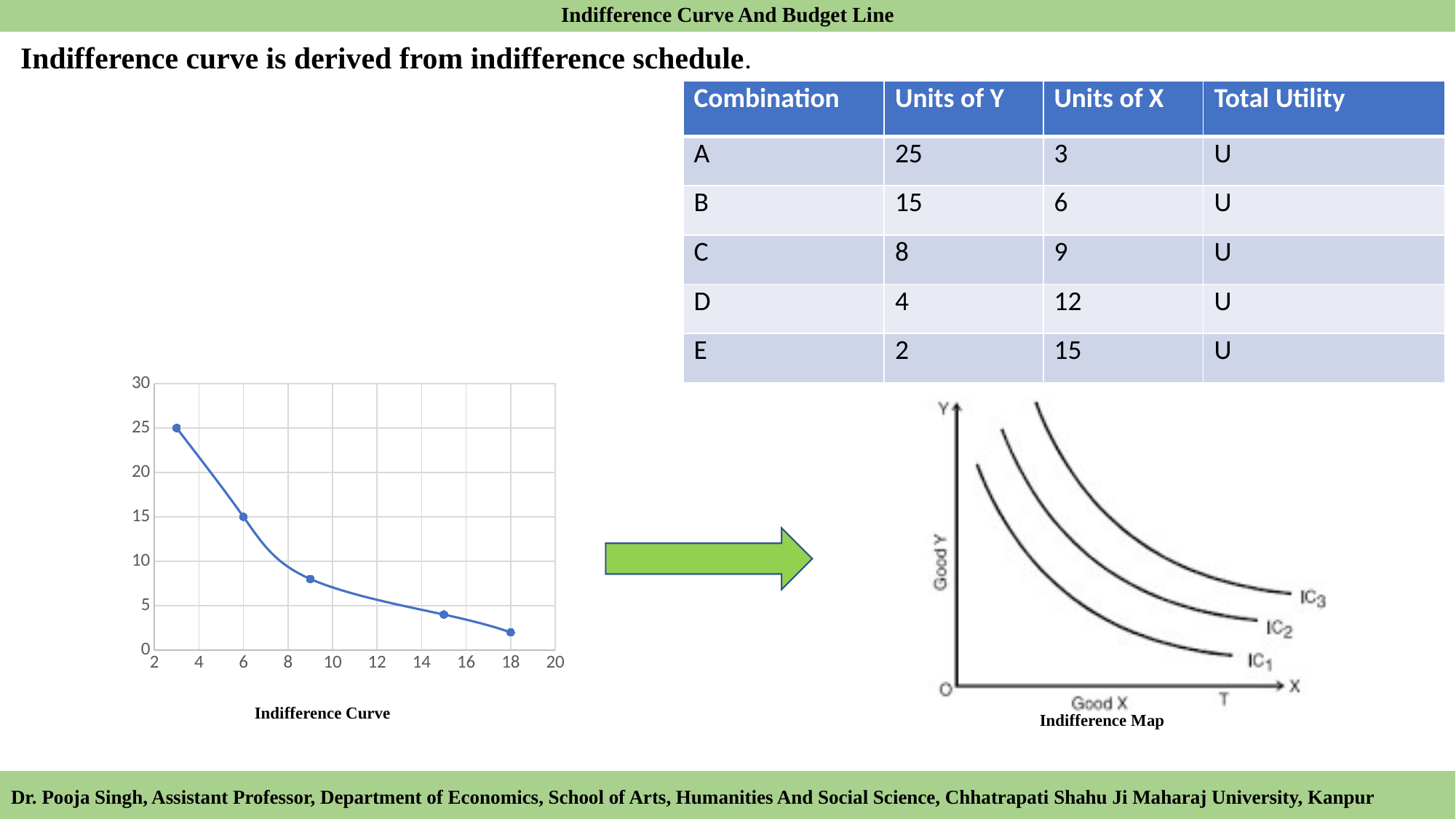
How many data points are plotted on the "Indifference Curve" chart? 5 What kind of chart is the "Indifference Curve" chart on the left of the slide? line chart On the "Indifference Curve" chart, is the y value of the leftmost point greater or less than 20? greater How many indifference curves are drawn in the "Indifference Map" diagram on the right? 3 On the "Indifference Curve" chart, which point has the larger y value: the one at x = 6 or the one at x = 9? the one at x = 6 On the "Indifference Curve" chart, what is the highest y value plotted? 25 On the "Indifference Curve" chart, what is the y value of the point plotted at x = 6? 15 On the "Indifference Curve" chart, is the y value of the point at x = 18 greater or less than 5? less What is the caption printed below the line chart on the left of the slide? Indifference Curve On the "Indifference Curve" chart, what is the highest value shown on the y axis? 30 On the "Indifference Curve" chart, do the values rise or fall as you move along the x axis from left to right? fall On the "Indifference Curve" chart, is the y value of the point at x = 9 greater or less than 10? less